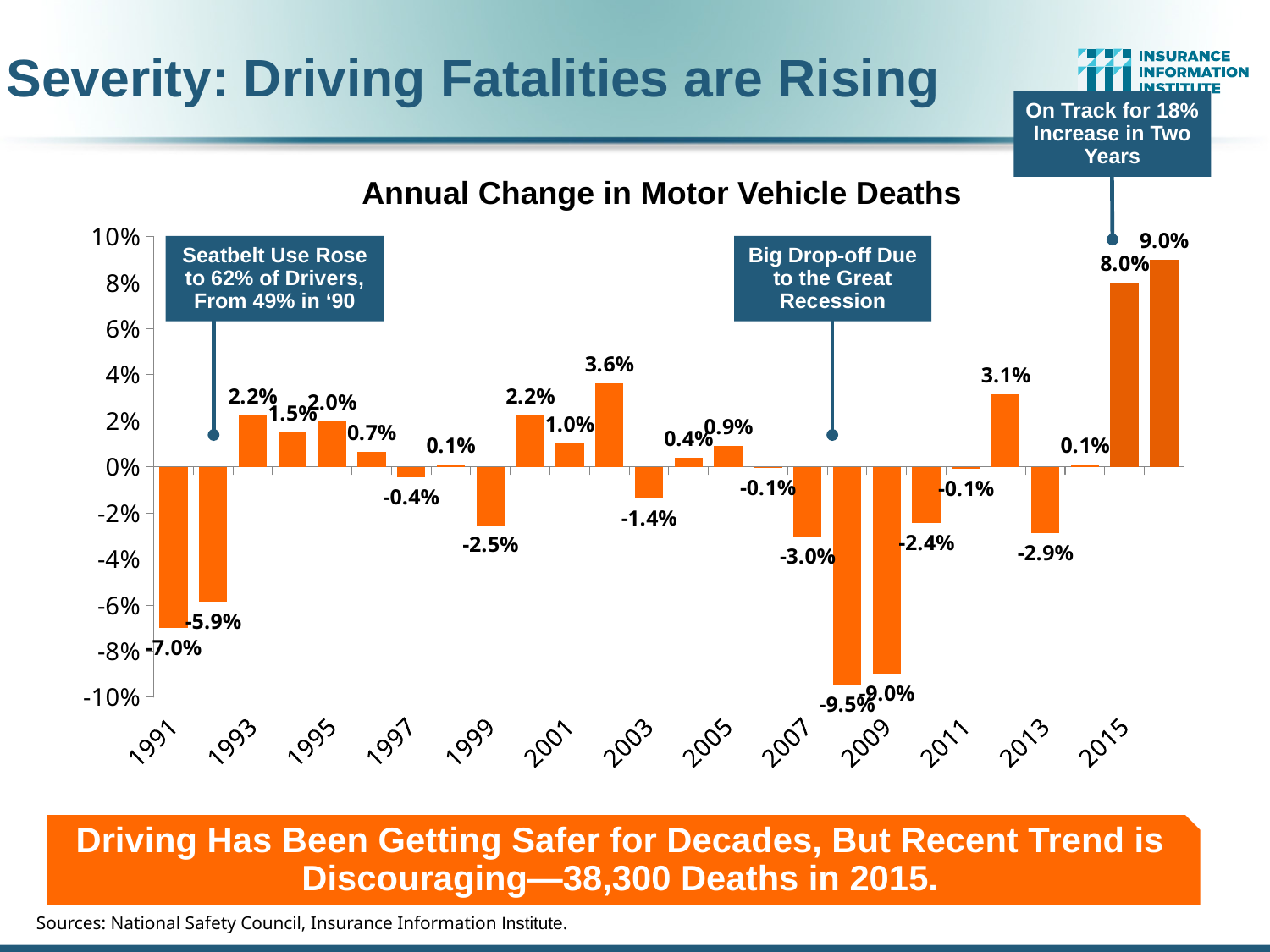
What is the highest value shown on the chart? 9.0% Which year has the larger annual change, 2007 or 2011? 2011 What is the annual change in motor vehicle deaths for 1991? -7.0% Is the value for 2015 greater or less than 6%? greater What is the title of the chart? Annual Change in Motor Vehicle Deaths What is the difference between the values for 2015 and 2013? 10.9 percentage points How many bars are plotted on the chart? 26 What kind of chart is shown on the slide? bar chart What is the annual change in motor vehicle deaths for 2015? 8.0% What is the lowest value shown on the chart? -9.5% What is the annual change in motor vehicle deaths for 2009? -9.0% What is the annual change in motor vehicle deaths for 2013? -2.9%